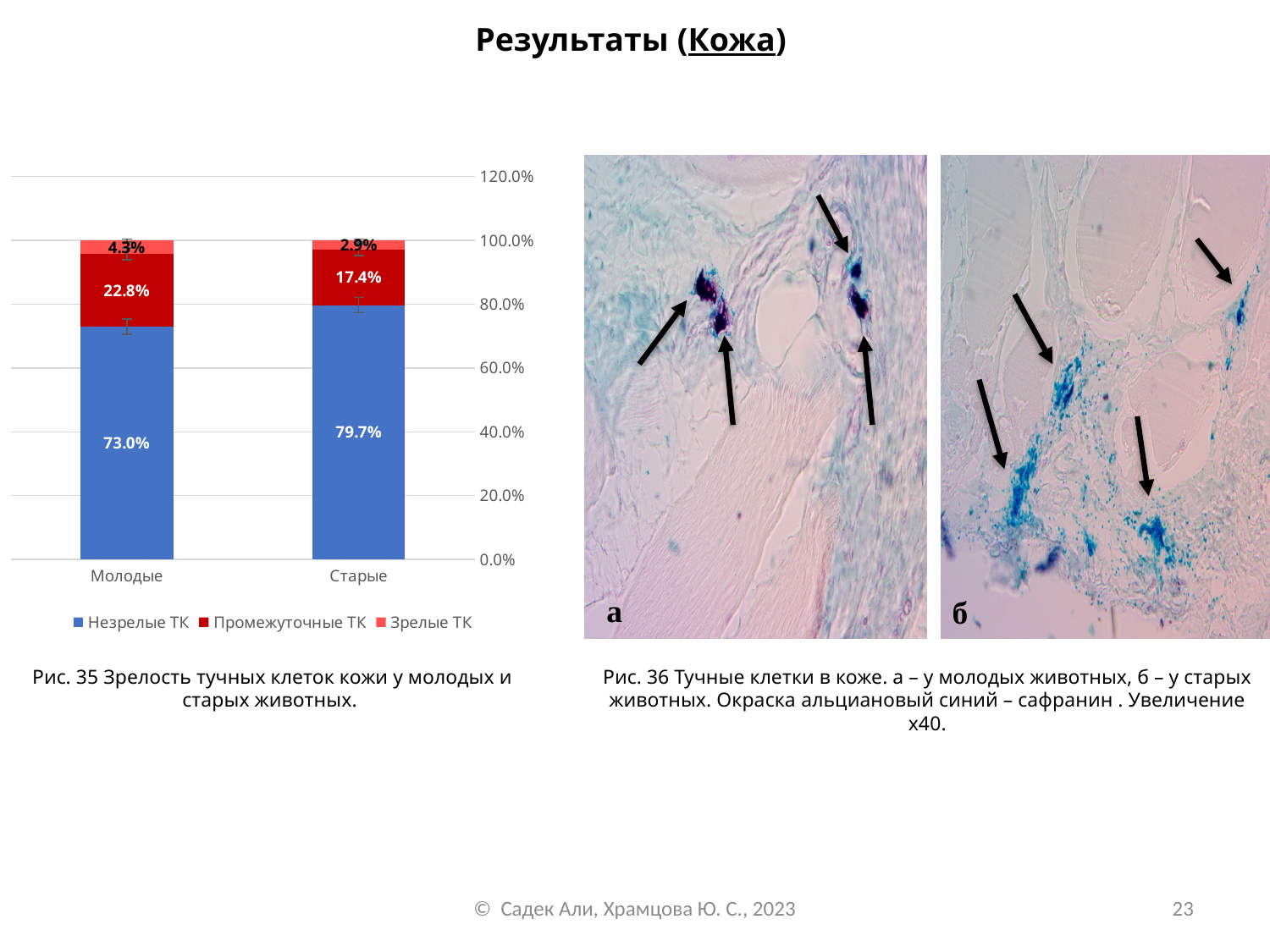
What is the value of Незрелые ТК for Молодые? 73.0% What is the value of Промежуточные ТК for Молодые? 22.8% How many series does the legend list? 3 What type of chart is shown on the slide? Stacked bar chart Which category has the larger Промежуточные ТК value, Молодые or Старые? Молодые Which category has the higher Незрелые ТК value? Старые What is the value of Зрелые ТК for Старые? 2.9% What is the total of the stacked bar for Старые? 100.0% What is the value of Незрелые ТК for Старые? 79.7% How many categories are shown on the x axis? 2 What is the value of Промежуточные ТК for Старые? 17.4% What is the difference between the Незрелые ТК values for Старые and Молодые? 6.7%